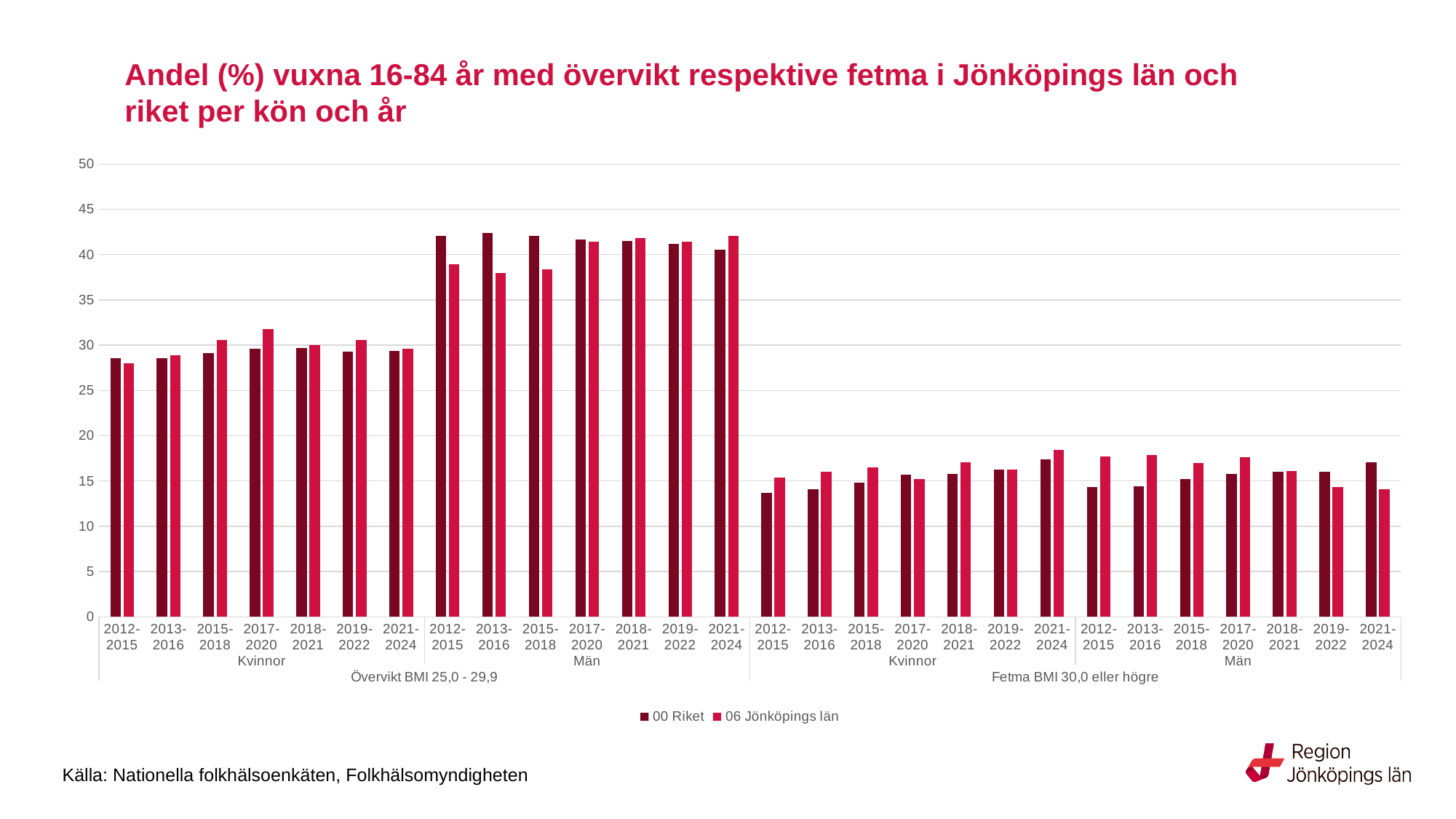
In the Fetma group for Män in 2012-2015, which series has the larger value, 00 Riket or 06 Jönköpings län? 06 Jönköpings län In the Övervikt group for Kvinnor in 2017-2020, which series has the larger value, 00 Riket or 06 Jönköpings län? 06 Jönköpings län In the Övervikt group for Män, is the value for 00 Riket in 2012-2015 greater or less than 40? greater How many year periods are shown for Kvinnor in the Övervikt BMI 25,0 - 29,9 group? 7 In the Övervikt group for Kvinnor, is the value for 06 Jönköpings län in 2017-2020 greater or less than 30? greater What kind of chart is shown on the slide? Bar chart In the Fetma group for Män, does the 00 Riket series rise or fall from 2012-2015 to 2021-2024? rise What are the two series named in the legend? 00 Riket and 06 Jönköpings län In the Fetma BMI 30,0 eller högre group for Kvinnor, is the value for 00 Riket in 2012-2015 greater or less than 15? less In the Övervikt group for Män in 2013-2016, which series has the larger value, 00 Riket or 06 Jönköpings län? 00 Riket How many series does the legend list? 2